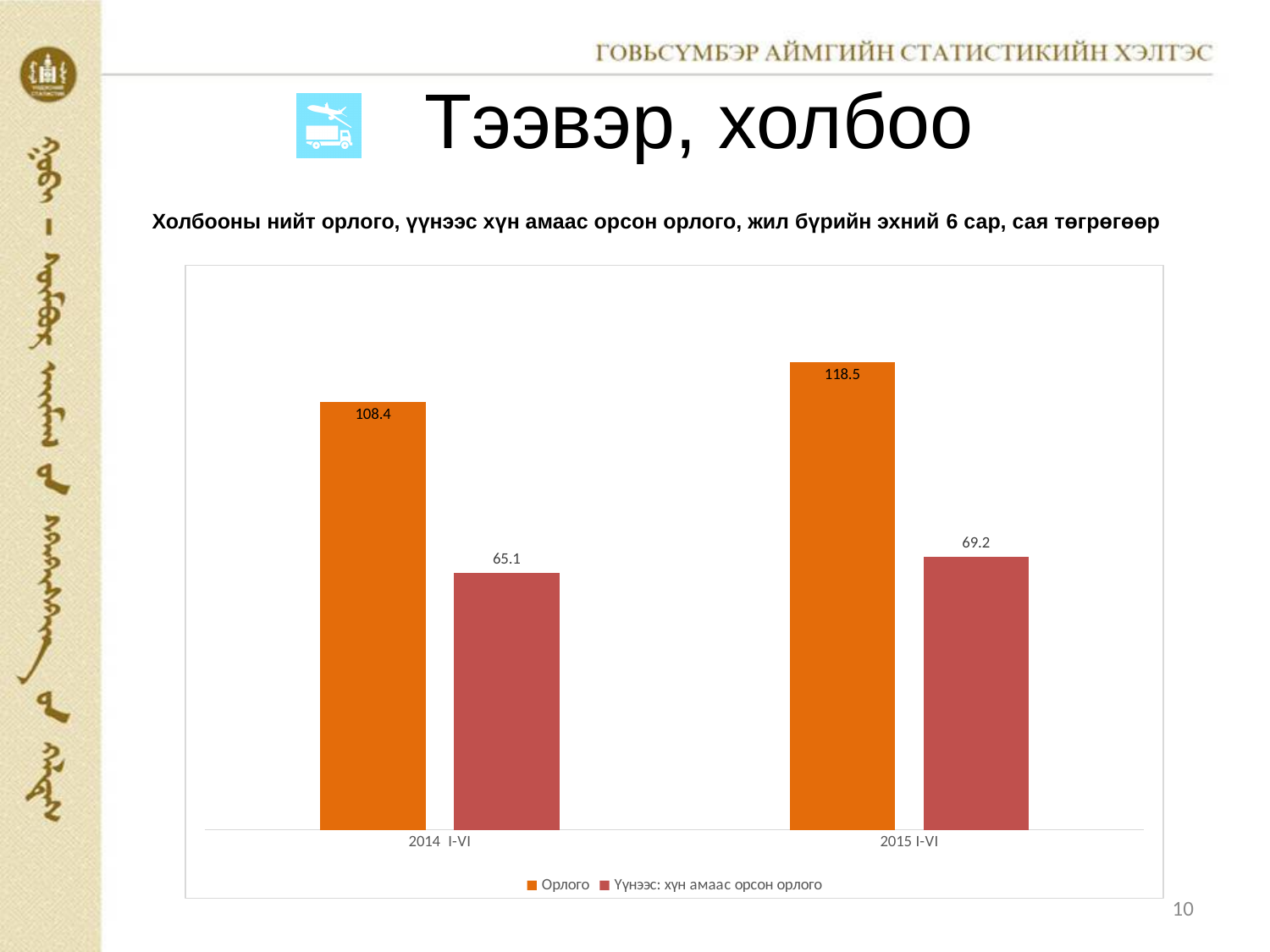
What is the value of Үүнээс: хүн амаас орсон орлого for 2014 I-VI? 65.1 What is the difference between Орлого and Үүнээс: хүн амаас орсон орлого for 2014 I-VI? 43.3 How many periods are shown on the x axis? 2 How many series does the legend list? 2 What kind of chart is shown on the slide? bar chart What is the value of Орлого for 2015 I-VI? 118.5 What is the difference between the Орлого values for 2015 I-VI and 2014 I-VI? 10.1 Which period has the higher Орлого value? 2015 I-VI What is the value of Үүнээс: хүн амаас орсон орлого for 2015 I-VI? 69.2 Is the Орлого value for 2014 I-VI larger or smaller than the Үүнээс: хүн амаас орсон орлого value for 2015 I-VI? larger Which period has the lower Үүнээс: хүн амаас орсон орлого value? 2014 I-VI What is the value of Орлого for 2014 I-VI? 108.4